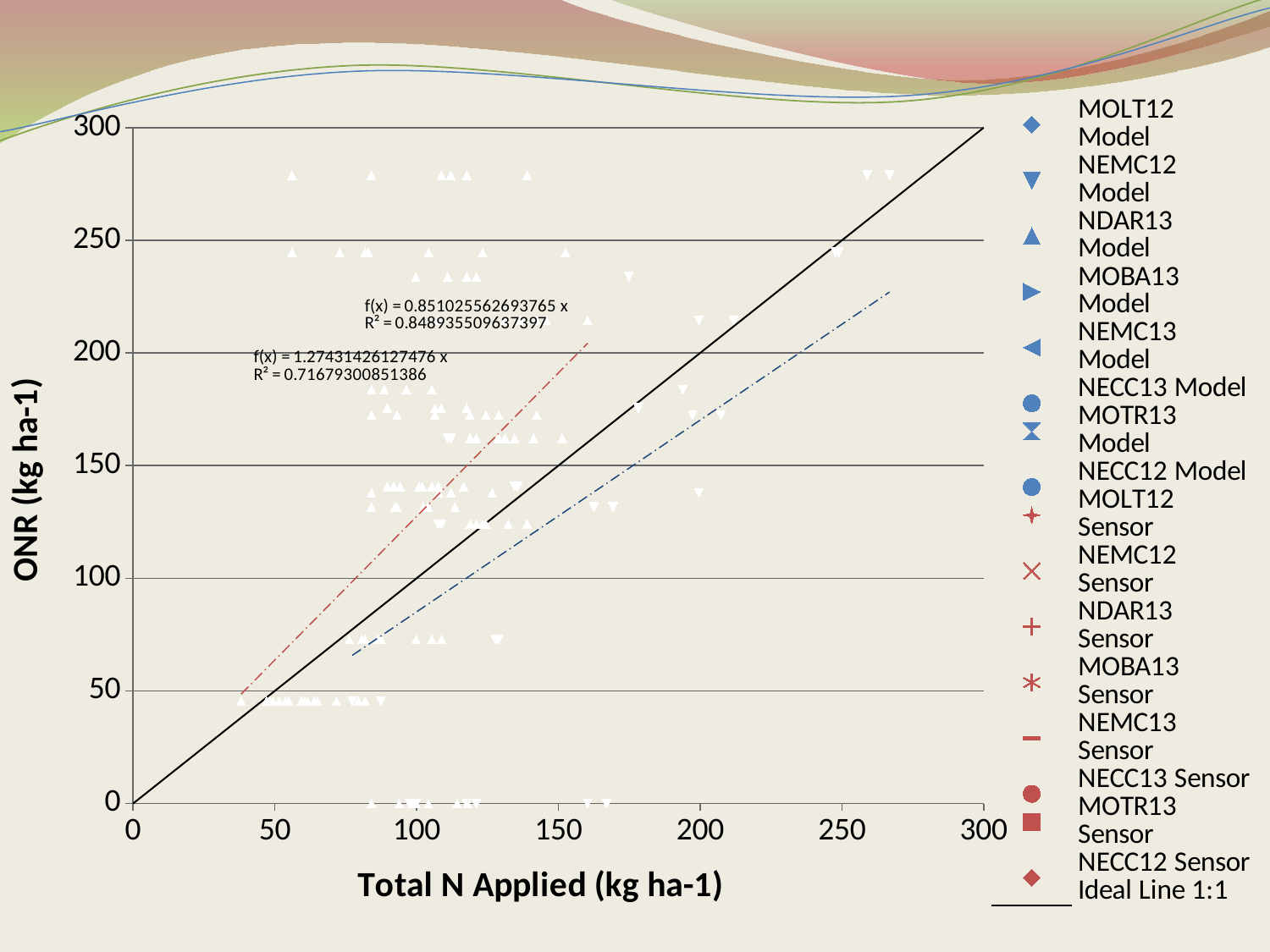
What is the R² value printed for the trendline with equation f(x) = 0.851025562693765 x? 0.848935509637397 What is the R² value printed for the trendline with equation f(x) = 1.27431426127476 x? 0.71679300851386 What is the name of the legend entry drawn as a solid black line? Ideal Line 1:1 What is the title of the x axis? Total N Applied (kg ha-1) What is the slope printed for the trendline with R² = 0.848935509637397? 0.851025562693765 What is the maximum value shown on the x axis? 300 What is the title of the y axis? ONR (kg ha-1) How many entries does the chart's legend list? 17 What is the maximum value shown on the y axis? 300 What kind of chart is shown on the slide? scatter chart What is the slope printed for the trendline with R² = 0.71679300851386? 1.27431426127476 Which of the two printed trendline slopes is larger, 0.851025562693765 or 1.27431426127476? 1.27431426127476